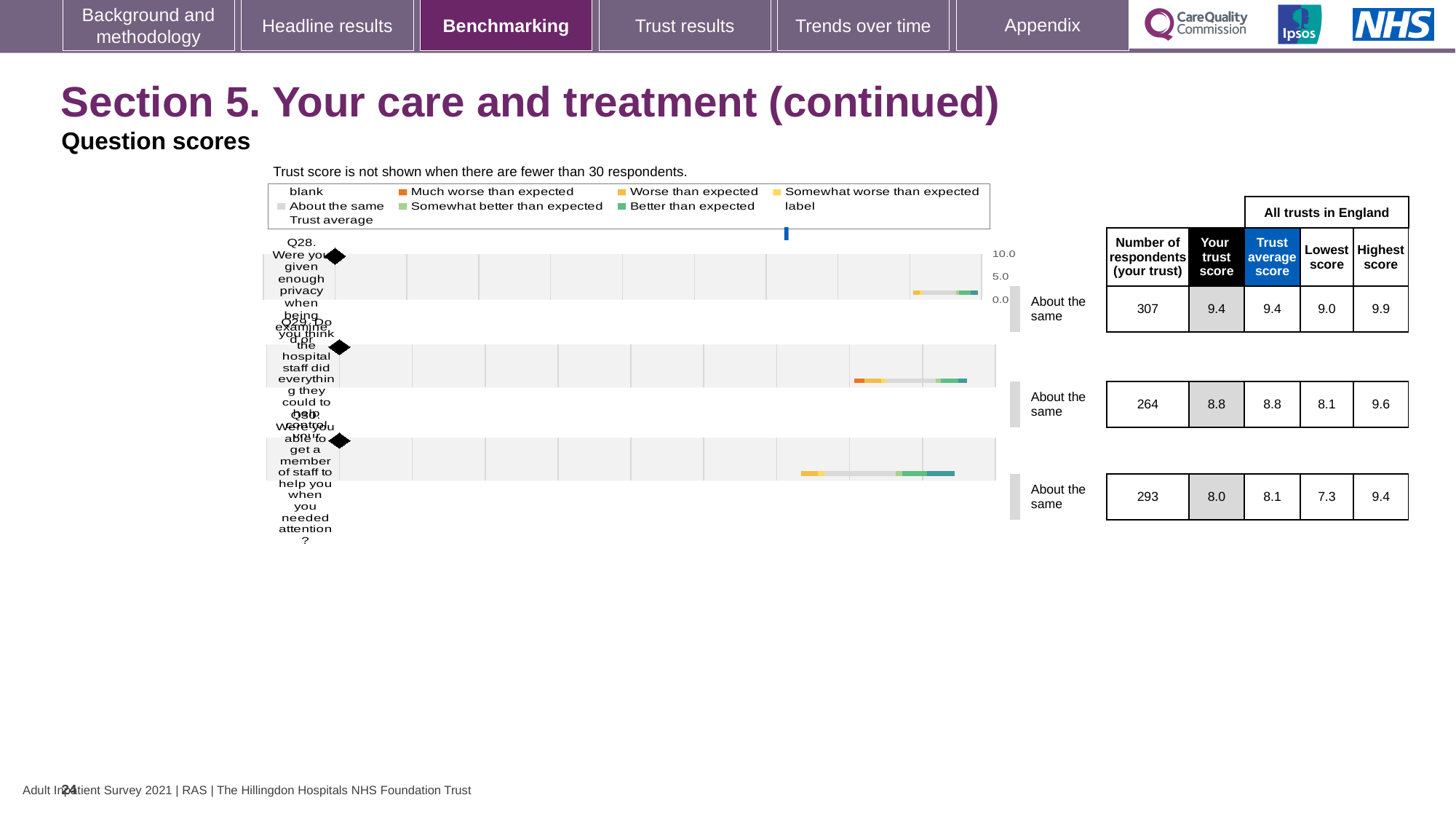
Which of the three questions has the highest trust score? Q28 Which of the three questions has the lowest trust score? Q30 For Q30, which is larger: the trust score or the trust average score? Trust average score What benchmark category is shown next to the chart for Q29? About the same What kind of chart is used to show the question scores on this slide? bar chart How many questions (Q28, Q29, Q30) are plotted in the question scores charts? 3 Is the trust score for Q30 greater or less than 5.0 on the chart axis? greater How many respondents from the trust answered Q28? 307 What is the trust average score for Q29 (Do you think the hospital staff did everything they could to help control your pain?)? 8.8 What is the difference between the highest score (9.9) and the lowest score (9.0) across all trusts in England for Q28? 0.9 What is the trust score for Q30 (Were you able to get a member of staff to help you when you needed attention?)? 8.0 What is the trust score for Q28 (Were you given enough privacy when being examined or treated?)? 9.4